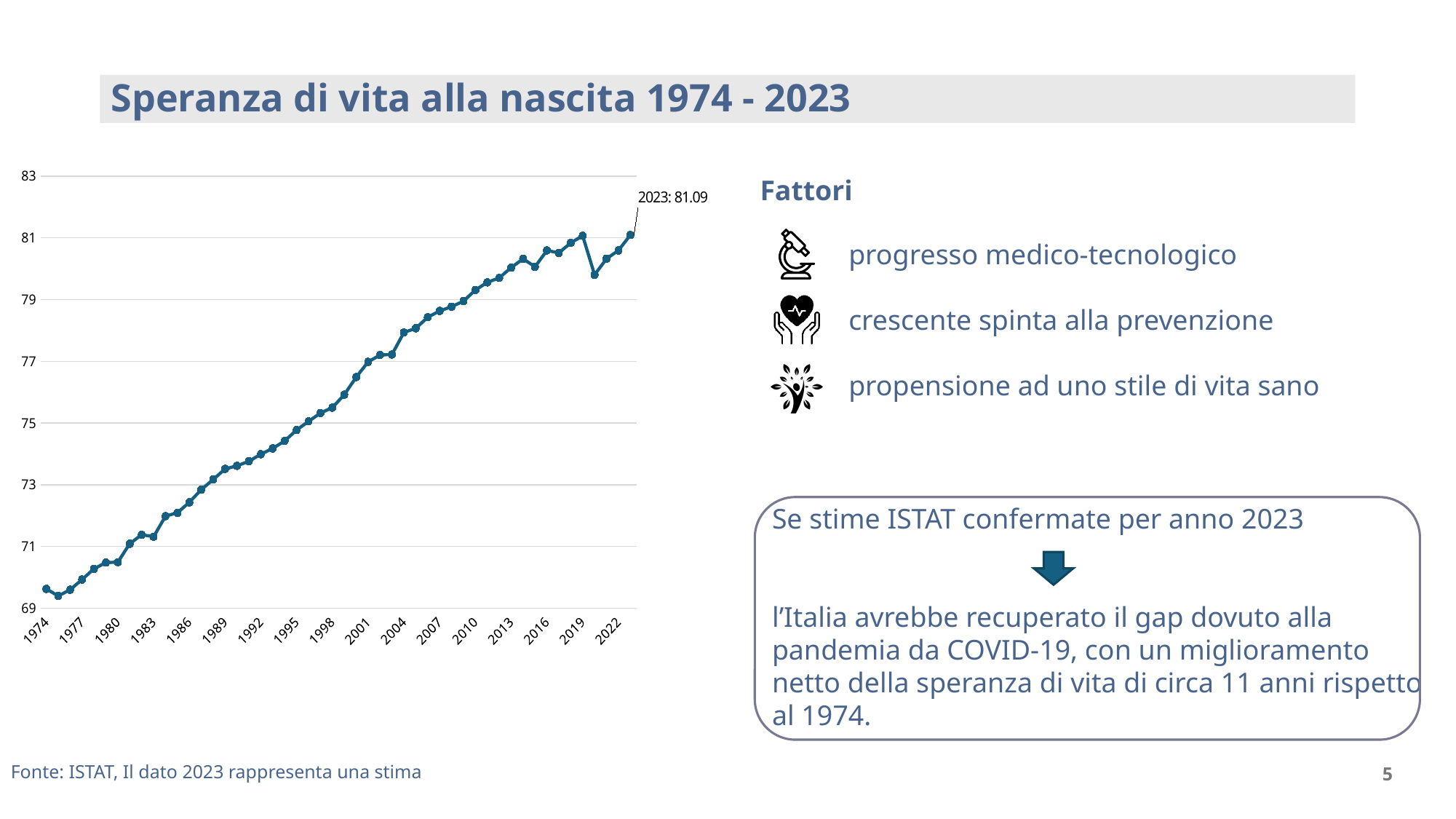
How many year labels are shown on the x axis? 17 What is the title of the chart? Speranza di vita alla nascita 1974 - 2023 Is the value for 1998 greater or less than 75? greater What is the life expectancy value labelled for 2023? 81.09 Is the value for 1974 greater or less than 71? less Which year has a larger value, 2019 or 2020? 2019 What kind of chart is shown on the slide? line chart What is the source cited for the chart data? ISTAT Is the value for 2020 greater or less than 81? less Overall, do the values rise or fall from 1974 to 2023? rise Which year has a larger value, 2020 or 2021? 2021